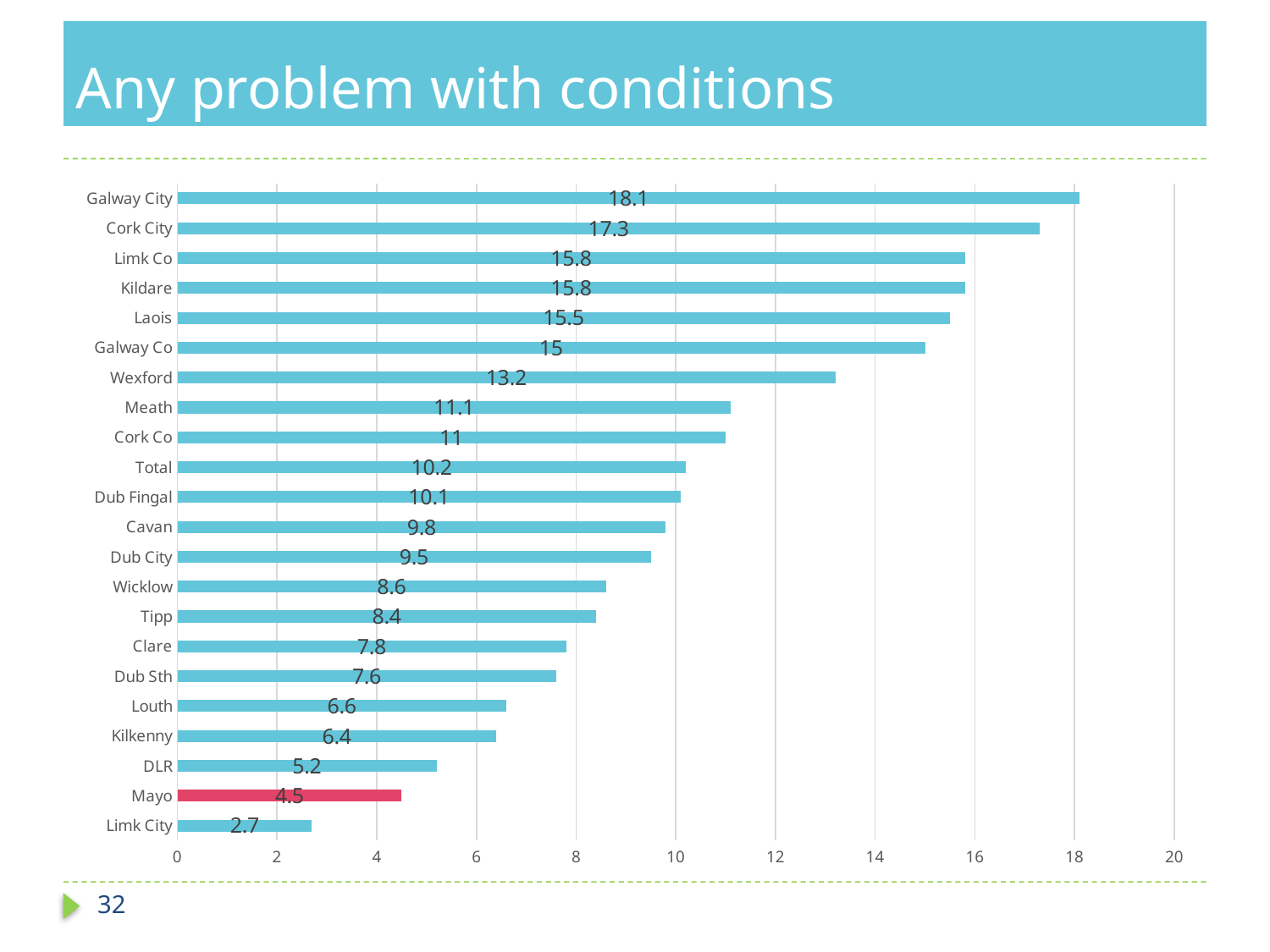
How many categories are shown on the chart? 22 Is the value for Laois greater or less than 14? greater What is the difference between the values for Galway City and Limk City? 15.4 Which bar is shown in a different colour (red) from the others? Mayo Which category has the lowest value? Limk City Which category has the highest value? Galway City Which is larger, the value for Cavan or the value for Wicklow? Cavan What kind of chart is shown on the slide? bar chart What is the difference between the values for Wexford and Meath? 2.1 What is the value for Galway City? 18.1 What is the value for Mayo? 4.5 What is the value for Total? 10.2